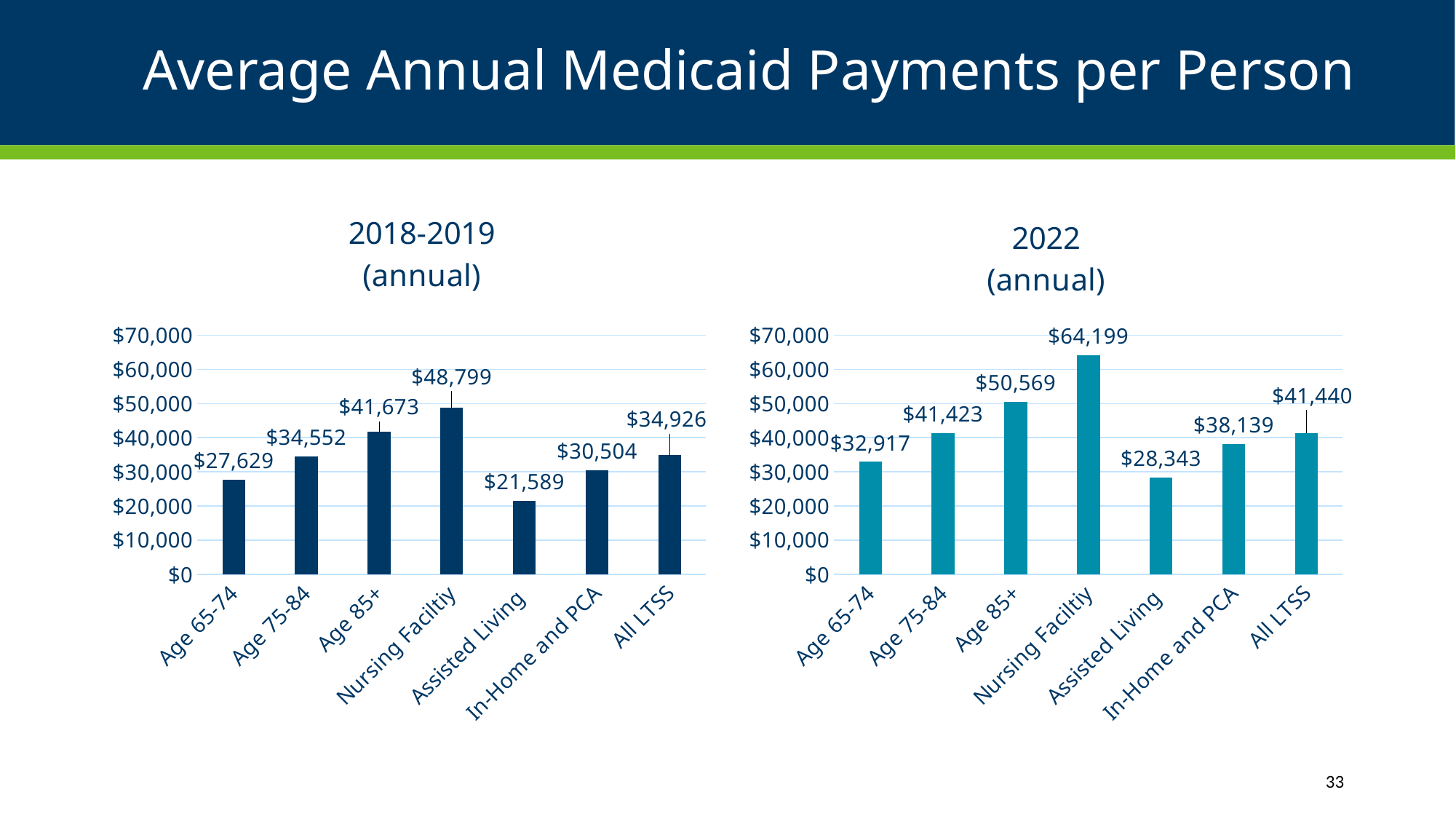
In the 2018-2019 (annual) chart, which category has the highest value? Nursing Facility What is the title of the slide? Average Annual Medicaid Payments per Person In the 2018-2019 (annual) chart, what is the average annual Medicaid payment for Nursing Facility? $48,799 In the 2022 (annual) chart, which is larger: the value for Age 85+ or the value for All LTSS? Age 85+ In the 2022 (annual) chart, which category has the lowest value? Assisted Living What is the difference between the Nursing Facility value in the 2022 (annual) chart and the Nursing Facility value in the 2018-2019 (annual) chart? $15,400 In the 2022 (annual) chart, what is the value for Age 75-84? $41,423 In the 2018-2019 (annual) chart, what is the difference between the Nursing Facility and Assisted Living values? $27,210 In the 2022 (annual) chart, what is the value for Assisted Living? $28,343 In the 2018-2019 (annual) chart, is the value for Age 65-74 greater or less than $30,000? less What type of chart is the 2018-2019 (annual) chart? Bar chart How many categories are shown in the 2022 (annual) chart? 7